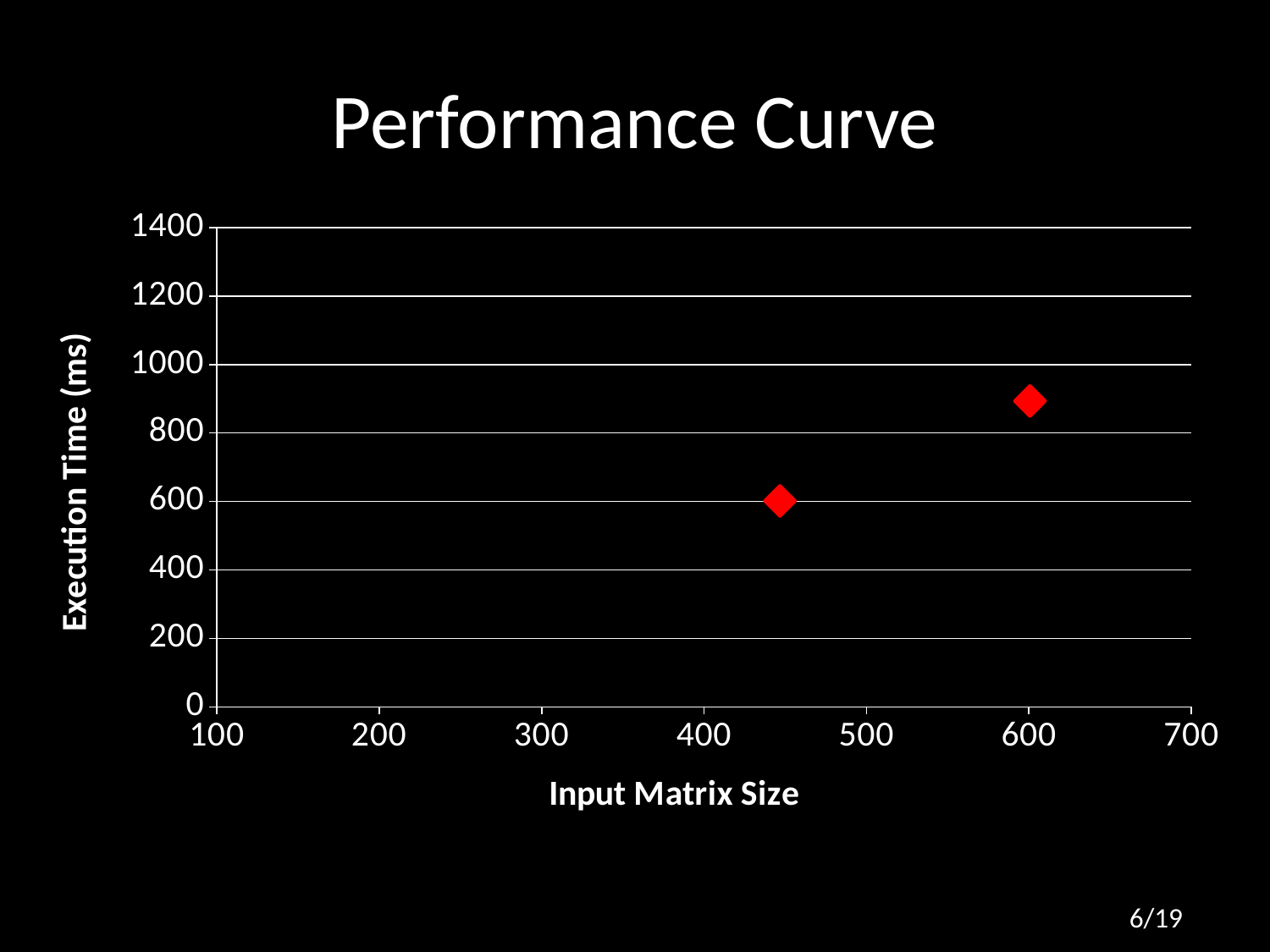
What is the title of the chart? Performance Curve What kind of chart is shown on the slide? scatter chart Is the execution time for the left-hand point greater or less than 800? less Is the execution time for the left-hand point greater or less than 400? greater How many data points are plotted on the chart? 2 Which point has the higher execution time, the left-hand point or the point at input matrix size 600? the point at input matrix size 600 Does execution time rise or fall as input matrix size increases? rise What is the highest value shown on the vertical axis? 1400 At which input matrix size is the execution time highest? 600 Is the execution time for the point at input matrix size 600 greater or less than 800? greater What is the label of the vertical axis? Execution Time (ms)